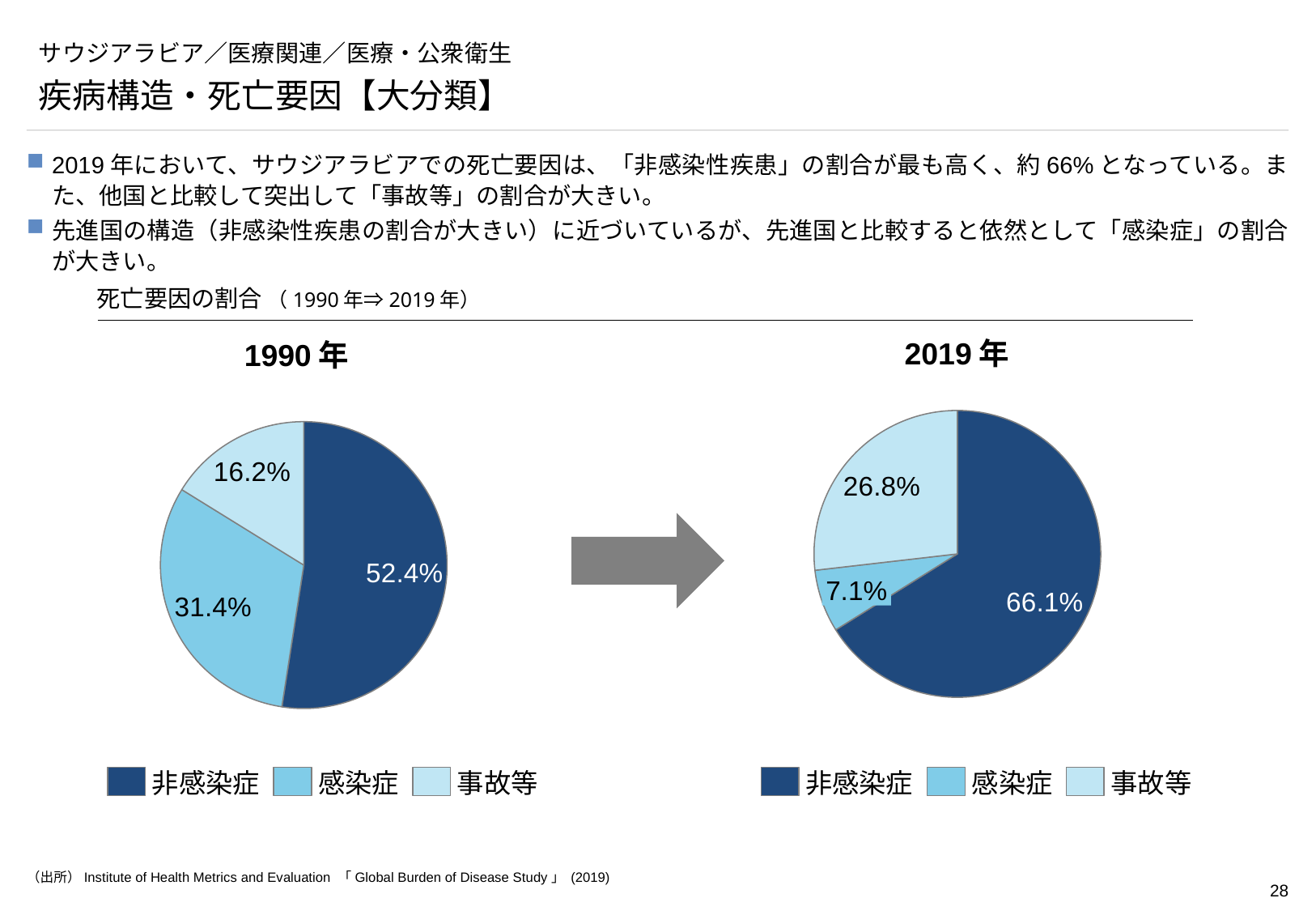
In the 2019年 pie chart, what share is shown for 感染症? 7.1% In the 2019年 pie chart, what share is shown for 事故等? 26.8% Which is larger: the 事故等 share in the 1990年 chart or the 事故等 share in the 2019年 chart? 2019年 In the 2019年 pie chart, which category has the smallest share? 感染症 How many slices does the 2019年 pie chart have? 3 In the 1990年 pie chart, which category has the smallest share? 事故等 What type of chart is used for the 1990年 data? Pie chart In the 2019年 pie chart, which category has the largest share? 非感染症 In the 1990年 pie chart, what share is shown for 非感染症? 52.4% In the 1990年 pie chart, what share is shown for 感染症? 31.4% What is the difference between the 非感染症 share in the 2019年 chart and the 非感染症 share in the 1990年 chart? 13.7 percentage points In the 1990年 pie chart, what is the difference between the 感染症 share and the 事故等 share? 15.2 percentage points